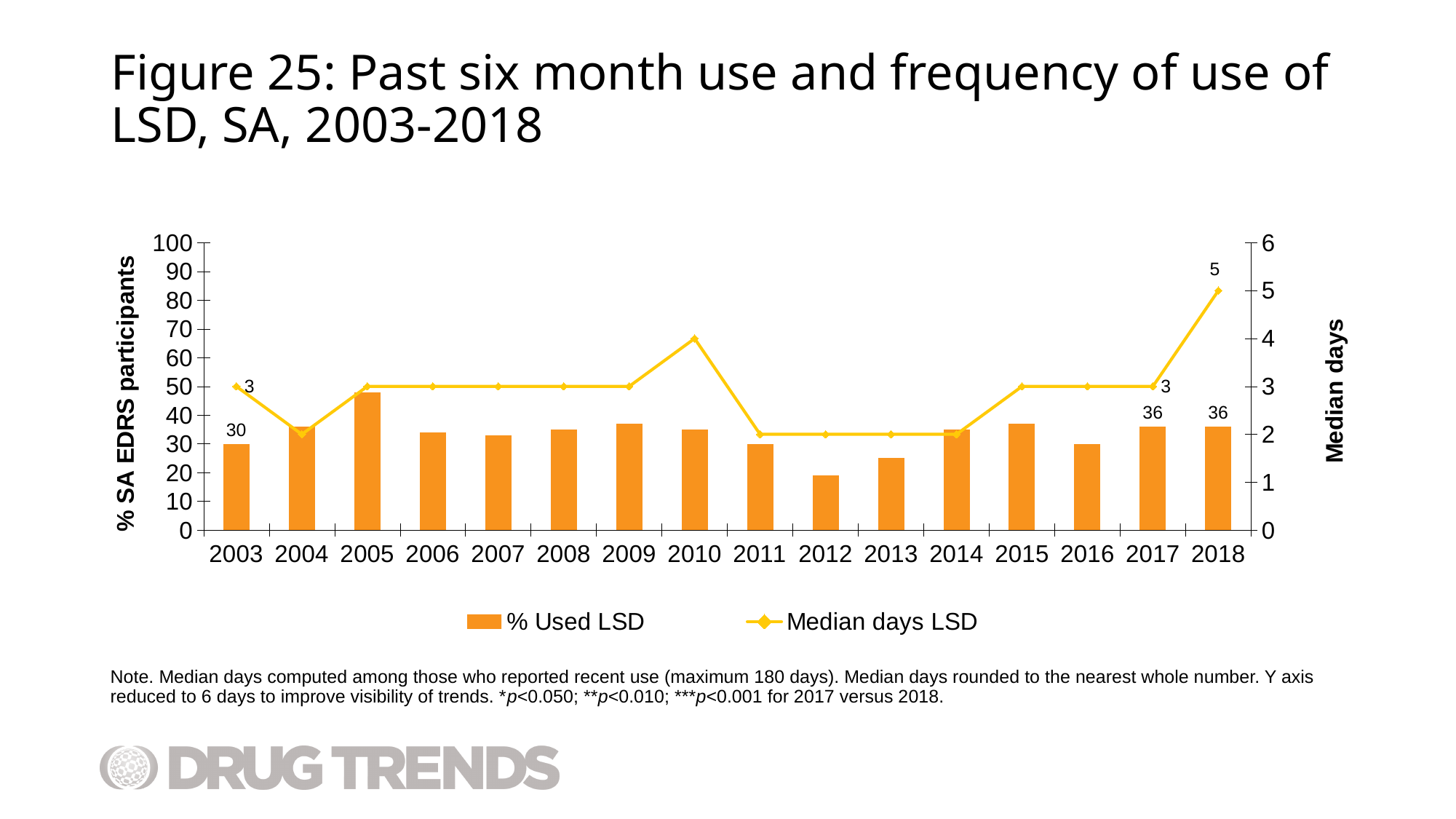
In which year was the median days LSD highest? 2018 By how many percentage points did % Used LSD change from 2003 to 2018? 6 What percentage of SA EDRS participants reported using LSD in 2003? 30 What was the median days of LSD use in 2018? 5 Which year has the higher % Used LSD, 2005 or 2012? 2005 How many years are shown on the x axis? 16 In which year was the % Used LSD bar the lowest? 2012 How many series does the legend list? 2 What was the median days of LSD use in 2017? 3 Is the % Used LSD value for 2005 greater or less than 40? greater What is the difference in median days LSD between 2017 and 2018? 2 What is the % Used LSD value for 2018? 36